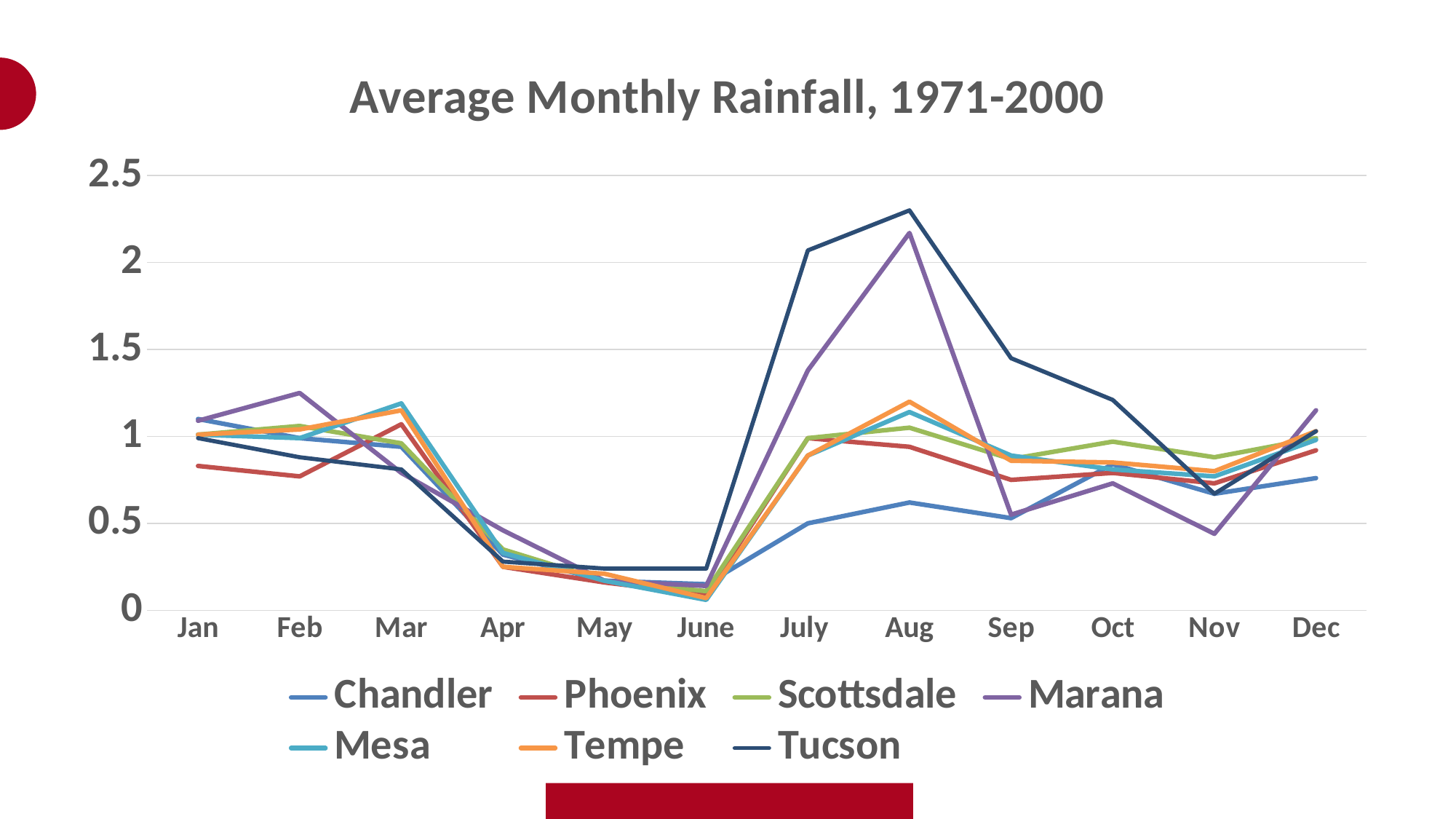
Which city has the highest value in Aug? Tucson Which city has the highest value in Feb? Marana In Nov, which is larger, the value for Chandler or the value for Marana? Chandler Is the value for Tucson in Aug greater or less than 2? greater Which city has the lowest value in Aug? Chandler What is the title of the chart? Average Monthly Rainfall, 1971-2000 How many months are shown along the x axis? 12 Is the value for Tucson in Oct greater or less than 1? greater What kind of chart is shown on the slide? line chart How many series does the legend list? 7 Is the value for Chandler in Aug greater or less than 1? less Does the Tucson line rise or fall from Aug to Nov? fall